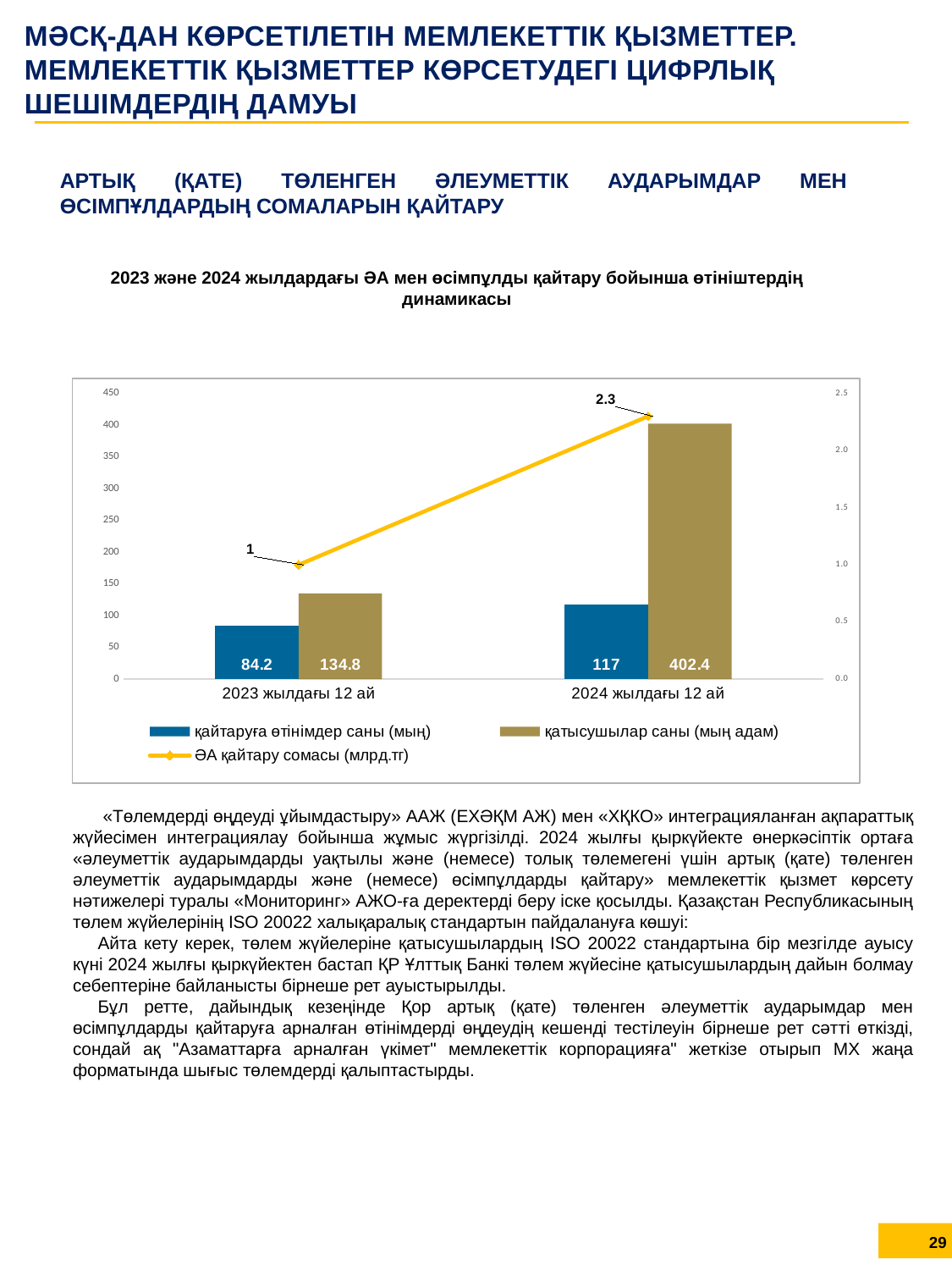
What is the value of "қатысушылар саны (мың адам)" for "2024 жылдағы 12 ай"? 402.4 What is the value of "қайтаруға өтінімдер саны (мың)" for "2024 жылдағы 12 ай"? 117 How many series does the chart legend list? 3 What is the value of "қайтаруға өтінімдер саны (мың)" for "2023 жылдағы 12 ай"? 84.2 What is the value of "ӘА қайтару сомасы (млрд.тг)" for "2024 жылдағы 12 ай"? 2.3 How many categories are shown on the x axis of the chart? 2 Which is larger for "2023 жылдағы 12 ай": "қайтаруға өтінімдер саны (мың)" or "қатысушылар саны (мың адам)"? қатысушылар саны (мың адам) Does the "ӘА қайтару сомасы (млрд.тг)" line rise or fall from 2023 to 2024? rise What is the difference in "қатысушылар саны (мың адам)" between "2024 жылдағы 12 ай" and "2023 жылдағы 12 ай"? 267.6 What is the value of "ӘА қайтару сомасы (млрд.тг)" for "2023 жылдағы 12 ай"? 1 Which category has the highest value for "қатысушылар саны (мың адам)"? 2024 жылдағы 12 ай What is the difference in "қайтаруға өтінімдер саны (мың)" between "2024 жылдағы 12 ай" and "2023 жылдағы 12 ай"? 32.8